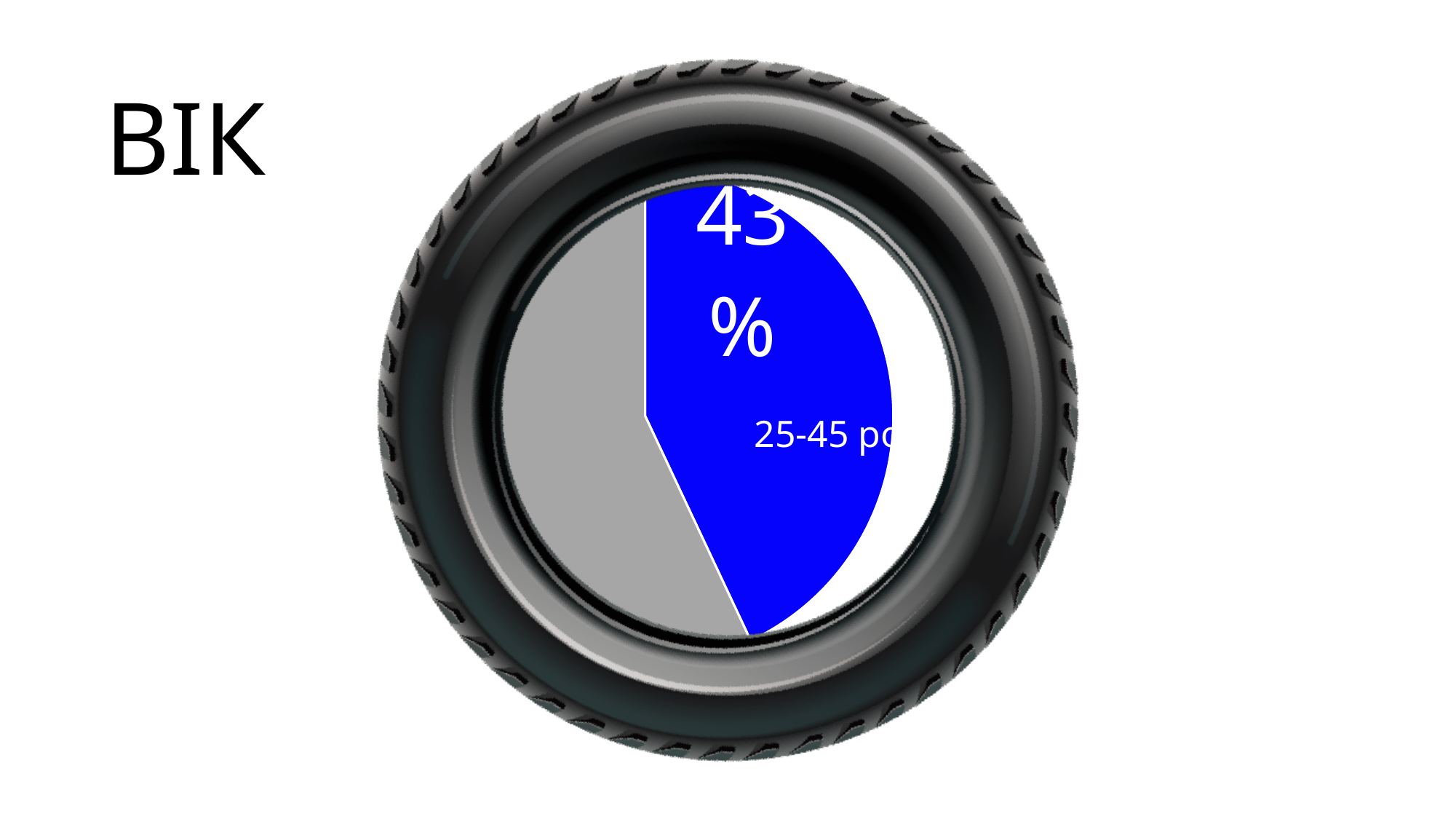
Is the value of the blue slice of the pie chart greater or less than 50%? less What colour is the slice of the pie chart labelled 43%? blue What text appears in the top-left corner of the slide? BIK What percentage is printed on the blue slice of the pie chart? 43% How many slices does the pie chart have? 2 Which slice of the pie chart is larger, the blue slice or the gray slice? gray What kind of chart is shown inside the tire image on the slide? pie chart